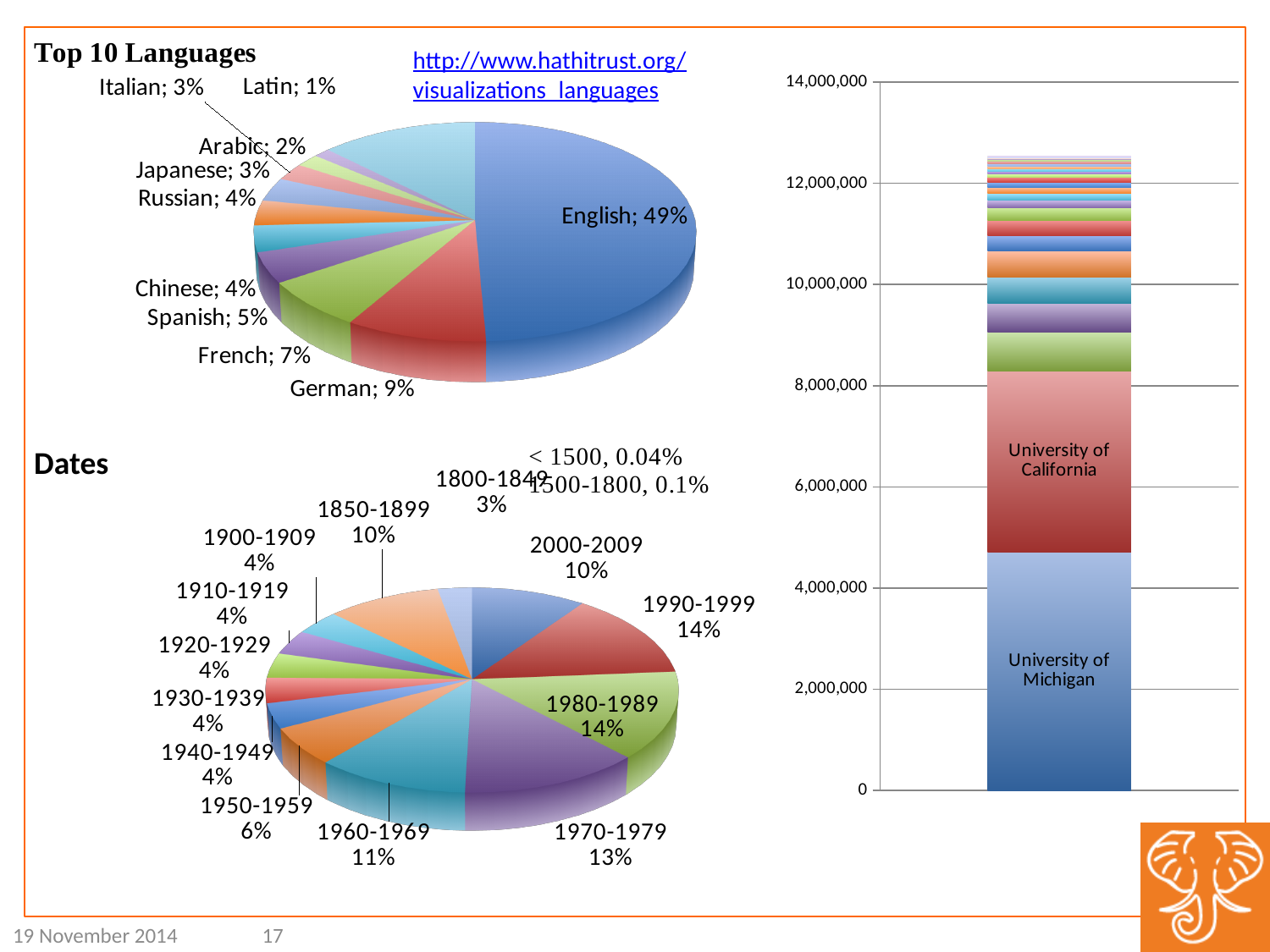
How many slices does the Top 10 Languages pie chart have? 11 In the Dates pie chart, which date range has the smallest share? < 1500 In the Dates pie chart, which has the larger share, 1960-1969 or 1950-1959? 1960-1969 In the Dates pie chart, what share does 1970-1979 have? 13% In the Top 10 Languages pie chart, what is the difference in percentage points between French and Spanish? 2 In the Top 10 Languages pie chart, what share does English have? 49% What kind of chart is the chart on the right side of the slide? Stacked bar chart In the Top 10 Languages pie chart, which has the larger share, Japanese or Russian? Russian In the Top 10 Languages pie chart, what share does German have? 9% In the stacked bar chart on the right, is the value for University of Michigan greater or less than 4,000,000? greater In the Top 10 Languages pie chart, which language has the smallest share? Latin